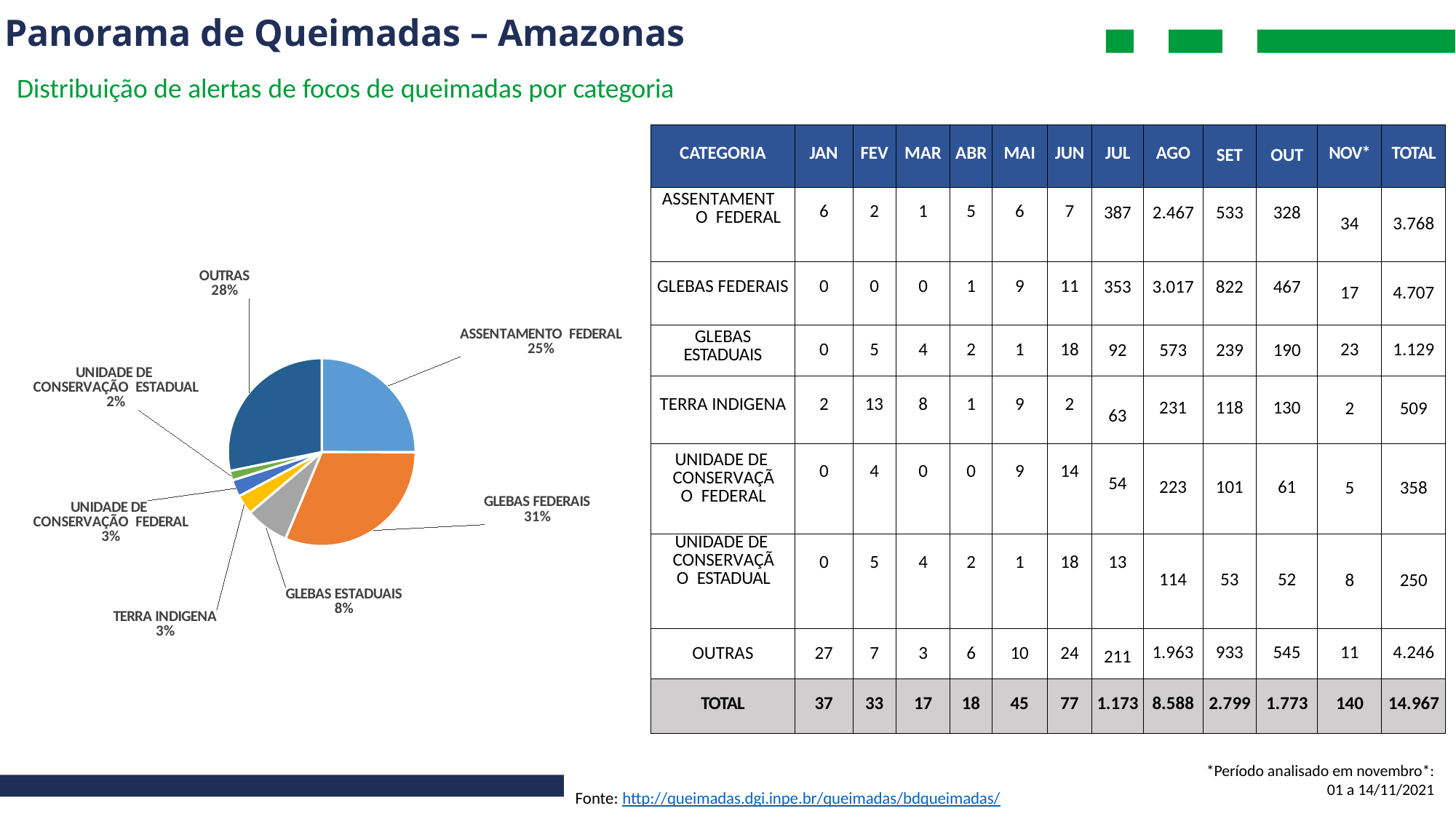
What share of the pie chart does GLEBAS ESTADUAIS represent? 8% What is the difference in percentage points between the GLEBAS FEDERAIS slice and the ASSENTAMENTO FEDERAL slice? 6 percentage points What share of the pie chart does UNIDADE DE CONSERVAÇÃO ESTADUAL represent? 2% Which category has the largest slice in the pie chart? GLEBAS FEDERAIS How many categories (slices) does the pie chart show? 7 What share of the pie chart does OUTRAS represent? 28% Which category has the smallest slice in the pie chart? UNIDADE DE CONSERVAÇÃO ESTADUAL Which slice is larger in the pie chart, OUTRAS or ASSENTAMENTO FEDERAL? OUTRAS What kind of chart is shown on the slide? Pie chart